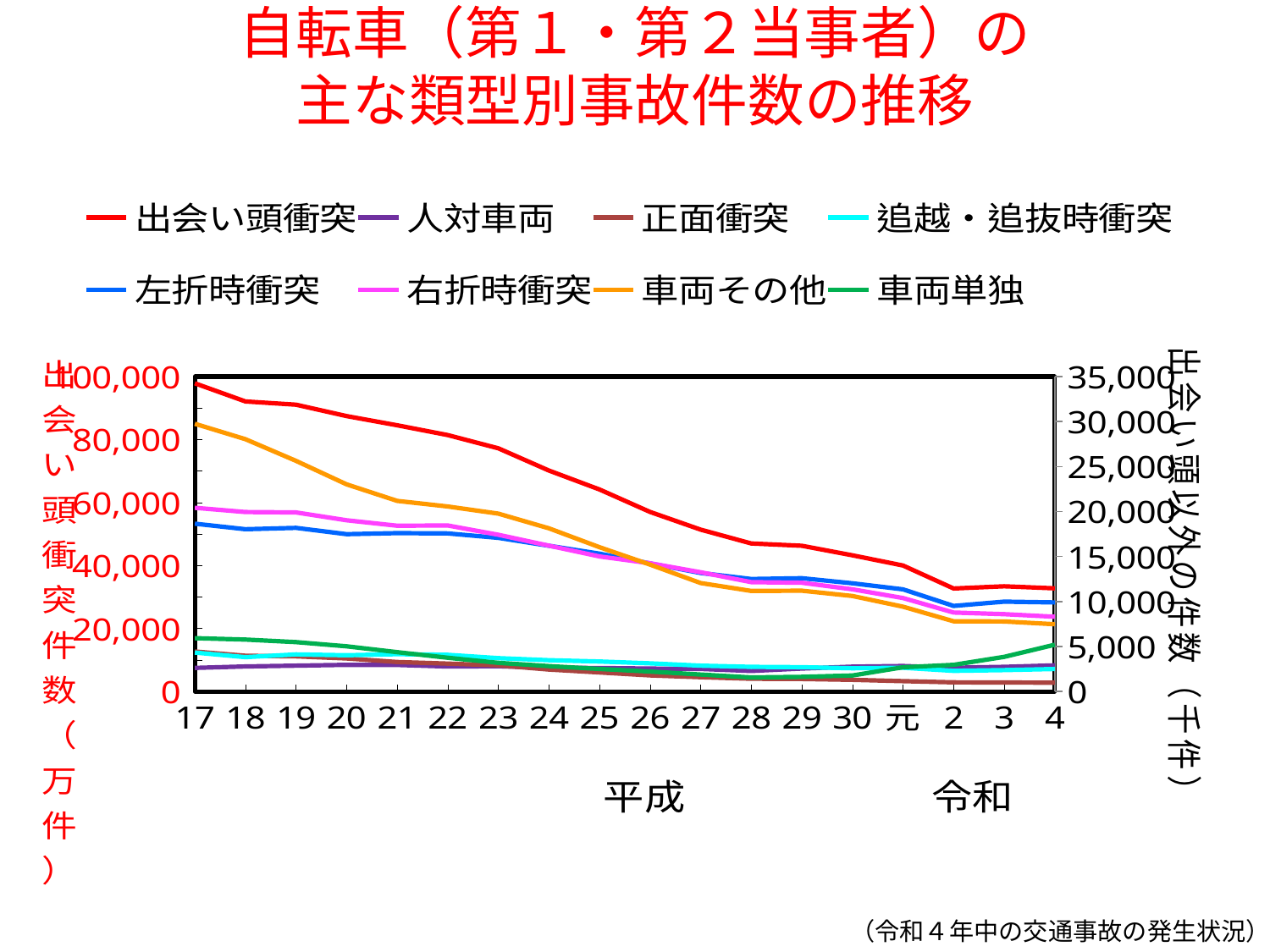
Does the 出会い頭衝突 line rise or fall from 平成17 to 令和4? fall Is the value for 出会い頭衝突 in 令和4 (left axis) greater or less than 40,000? less How many series does the legend list? 8 What colour is the 出会い頭衝突 line in the legend? red How many points along the x axis does each line have? 18 What kind of chart is shown on the slide? line chart In 平成17, which is larger: 車両その他 or 左折時衝突? 車両その他 In 令和4, which is larger: 左折時衝突 or 車両その他? 左折時衝突 Does the 車両その他 line rise or fall from 平成17 to 令和4? fall Is the value for 車両その他 in 平成17 (right axis) greater or less than 25,000? greater Is the value for 左折時衝突 in 平成17 (right axis) greater or less than 15,000? greater